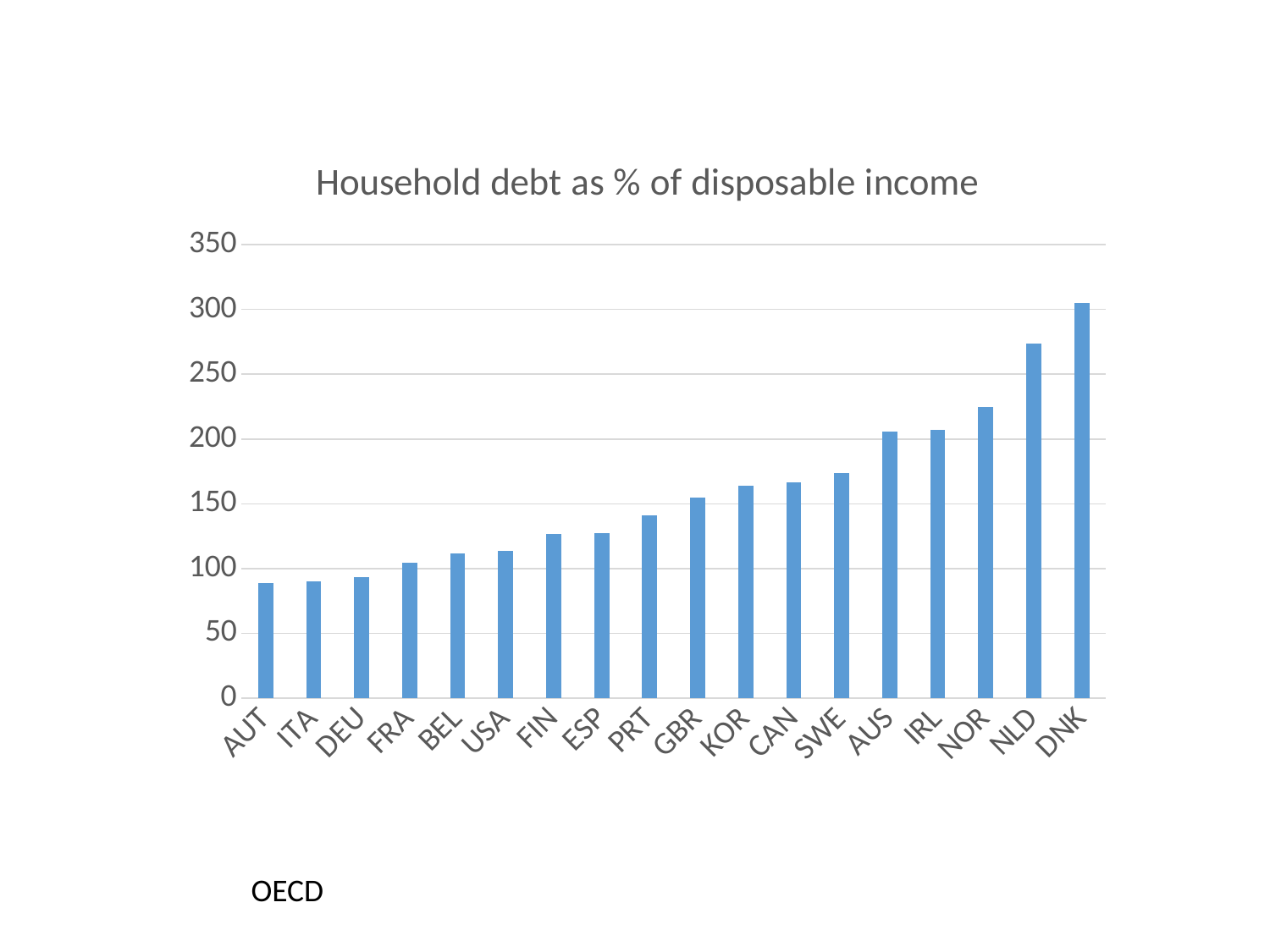
Is the value for SWE greater or less than 200? less Which has the larger value, NLD or NOR? NLD Do the values rise or fall moving from left to right along the x axis? rise Is the value for AUT greater or less than 100? less What is the title of the chart? Household debt as % of disposable income How many countries are shown on the x axis of the chart? 18 Is the value for NLD greater or less than 250? greater What kind of chart is shown on the slide? bar chart Which has the larger value, FRA or GBR? GBR Which country has the highest household debt as % of disposable income? DNK